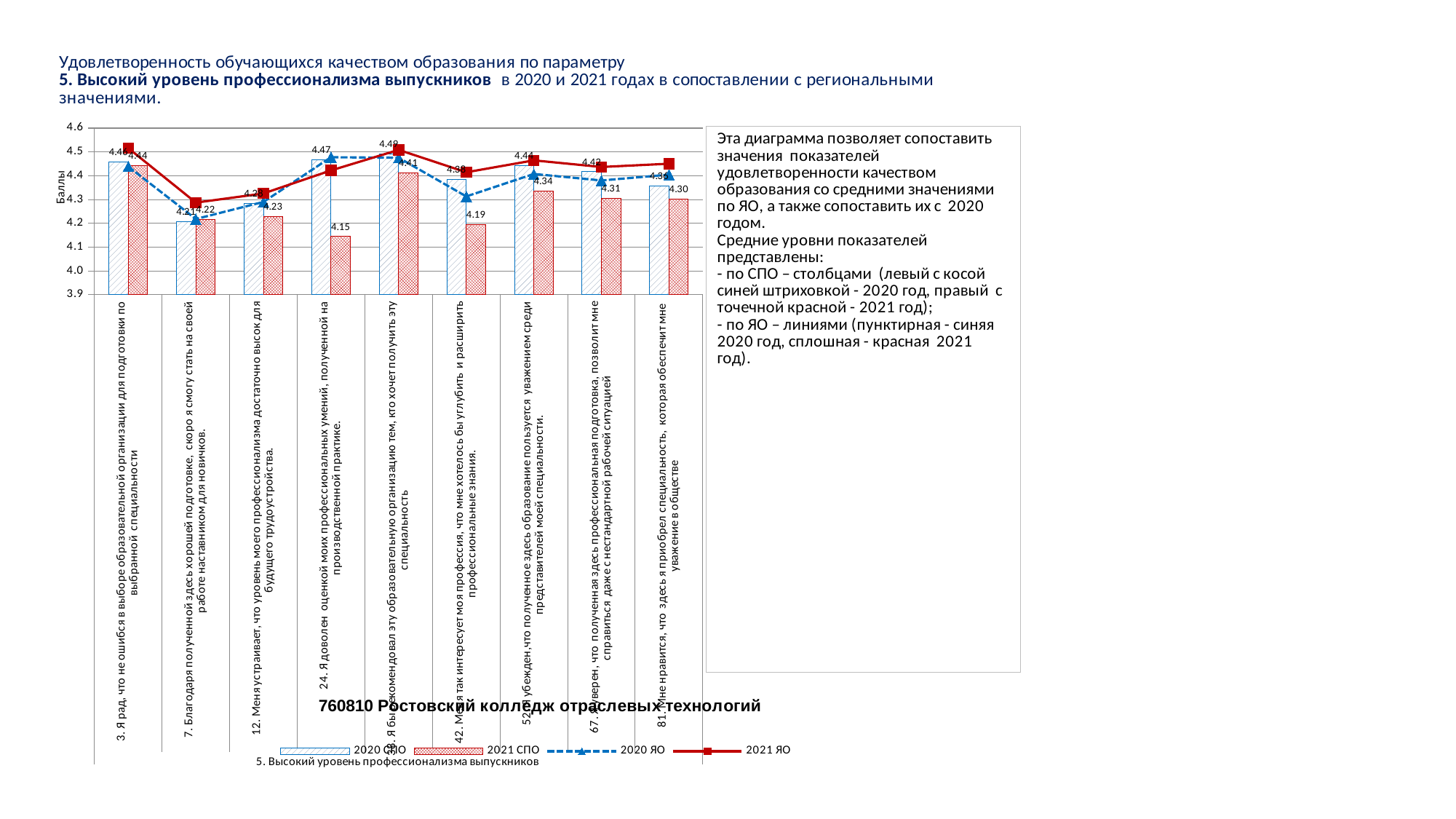
Which statement has the lowest 2021 СПО value? 24. Я доволен оценкой моих профессиональных умений, полученной на производственной практике What kind of chart is shown on the slide? Combined bar and line chart For statement 52 ("Я убежден, что полученное здесь образование пользуется уважением среди представителей моей специальности"), which is larger: the 2020 СПО value or the 2021 СПО value? 2020 СПО Which statement has the highest 2020 СПО value? 38. Я бы рекомендовал эту образовательную организацию тем, кто хочет получить эту специальность What is the 2020 СПО value for statement 38 ("Я бы рекомендовал эту образовательную организацию тем, кто хочет получить эту специальность")? 4.49 What is the 2021 СПО value for statement 81 ("Мне нравится, что здесь я приобрел специальность, которая обеспечит мне уважение в обществе")? 4.30 What is the 2021 СПО value for statement 42 ("Меня так интересует моя профессия, что мне хотелось бы углубить и расширить профессиональные знания")? 4.19 How many statements (categories) are shown on the x axis of the chart? 9 Is the 2021 ЯО value for statement 7 ("Благодаря полученной здесь хорошей подготовке, скоро я смогу стать на своей работе наставником для новичков") greater or less than 4.4? less What is the 2021 СПО value for statement 24 ("Я доволен оценкой моих профессиональных умений, полученной на производственной практике")? 4.15 What is the difference between the 2020 СПО and 2021 СПО values for statement 24? 0.32 How many series does the chart legend list? 4